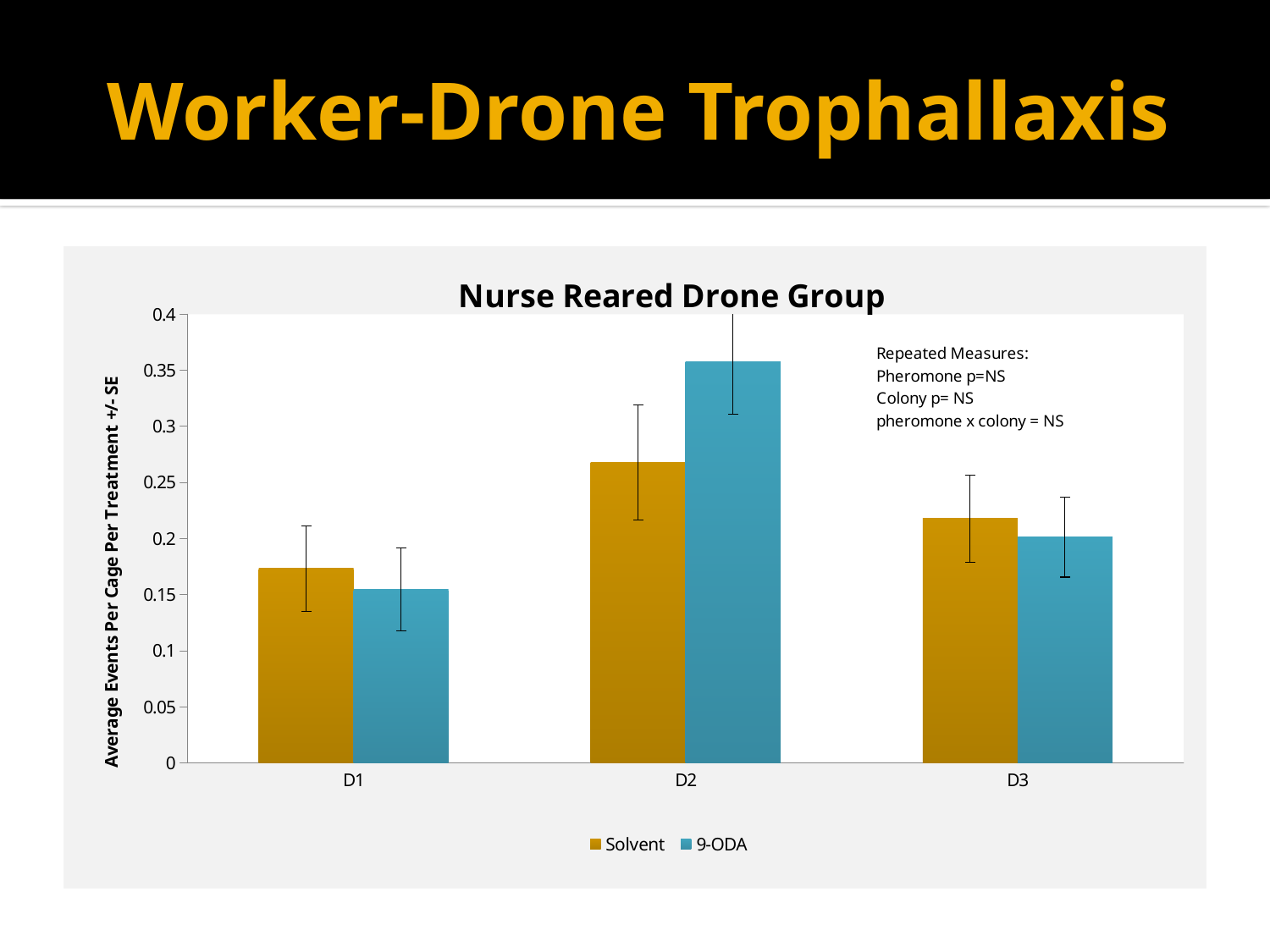
Is the 9-ODA value for D2 greater or less than 0.3? greater In group D2, which is larger, the Solvent bar or the 9-ODA bar? 9-ODA Which drone group has the highest Solvent bar? D2 What kind of chart is shown on the slide? Bar chart How many drone groups are shown on the x axis? 3 Is the Solvent value for D1 greater or less than 0.2? less What is the title of the chart? Nurse Reared Drone Group In group D1, which is larger, the Solvent bar or the 9-ODA bar? Solvent How many series does the legend list? 2 What is the label of the y axis? Average Events Per Cage Per Treatment +/- SE Which drone group has the lowest 9-ODA bar? D1 Which series and group has the highest bar? 9-ODA in D2